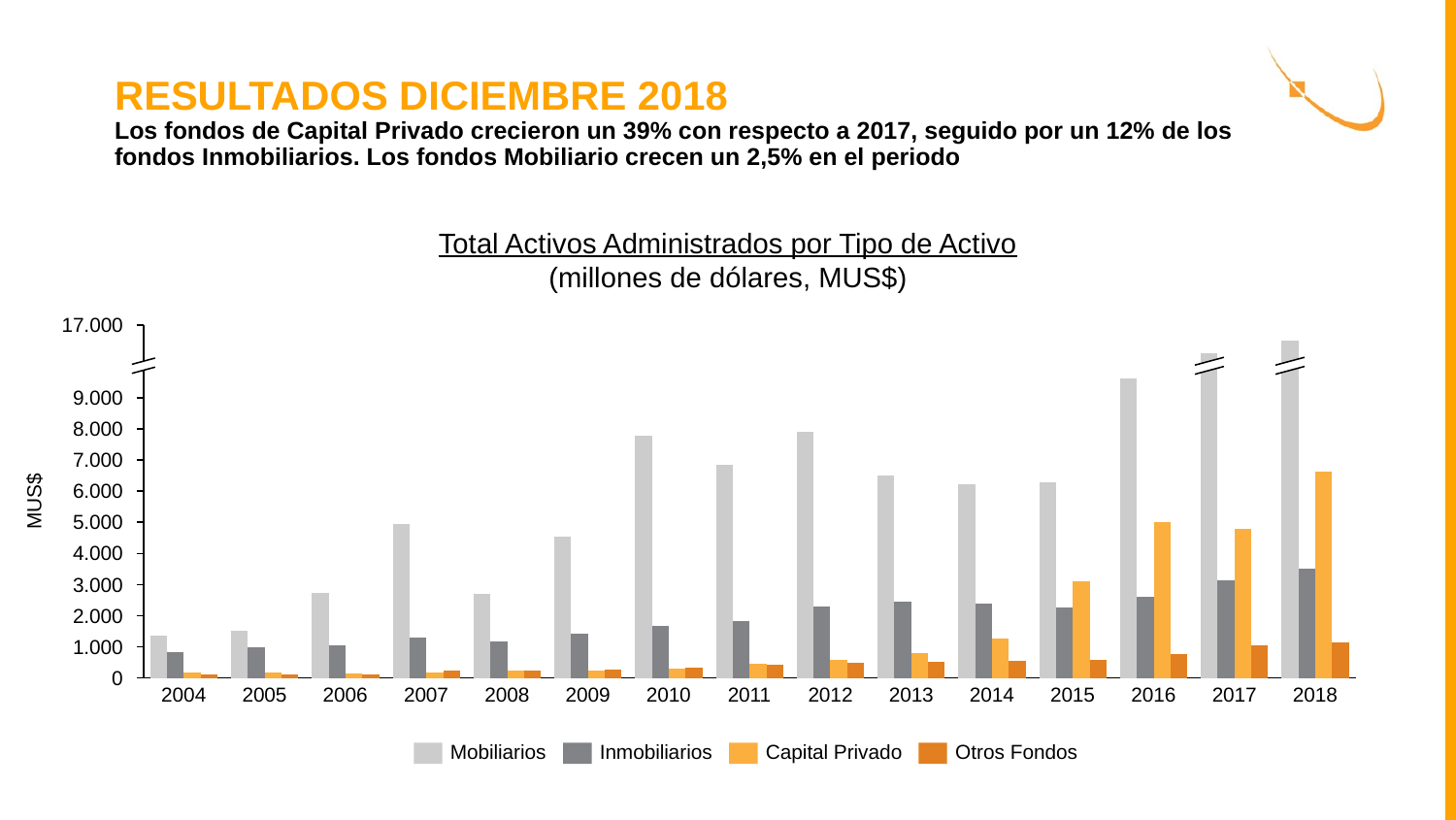
Is the value for Mobiliarios in 2010 greater or less than 7.000? greater What unit is shown on the y axis label? MUS$ How many years are shown on the x axis? 15 How many series does the legend list? 4 Is the value for Inmobiliarios in 2018 greater or less than 3.000? greater In which year is the Mobiliarios bar the highest? 2018 In 2018, which is larger: Capital Privado or Inmobiliarios? Capital Privado Is the value for Capital Privado in 2018 greater or less than 6.000? greater Do the Capital Privado values generally rise or fall from 2004 to 2018? Rise What kind of chart is shown on the slide? Bar chart What is the title of the chart? Total Activos Administrados por Tipo de Activo